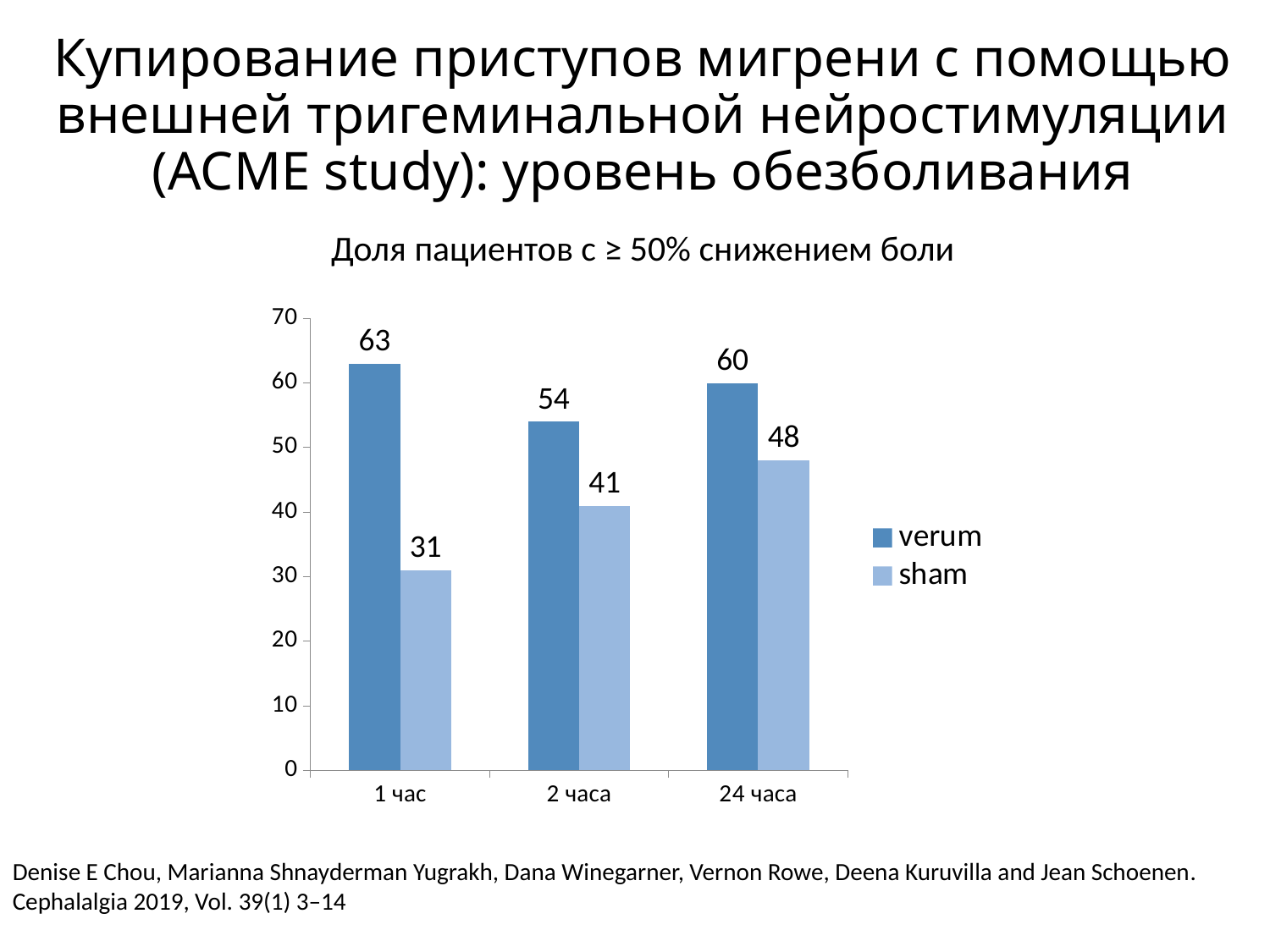
What kind of chart is shown? bar chart What is the sham value at 2 часа? 41 At which time point is the sham value lowest? 1 час What is the verum value at 1 час? 63 How many time points are shown on the x axis? 3 Does the sham value rise or fall from 1 час to 24 часа? rise What is the sham value at 24 часа? 48 What is the difference between the verum and sham values at 1 час? 32 Which is larger at 2 часа, verum or sham? verum At which time point is the verum value highest? 1 час How many series does the legend list? 2 What is the difference between the verum and sham values at 24 часа? 12